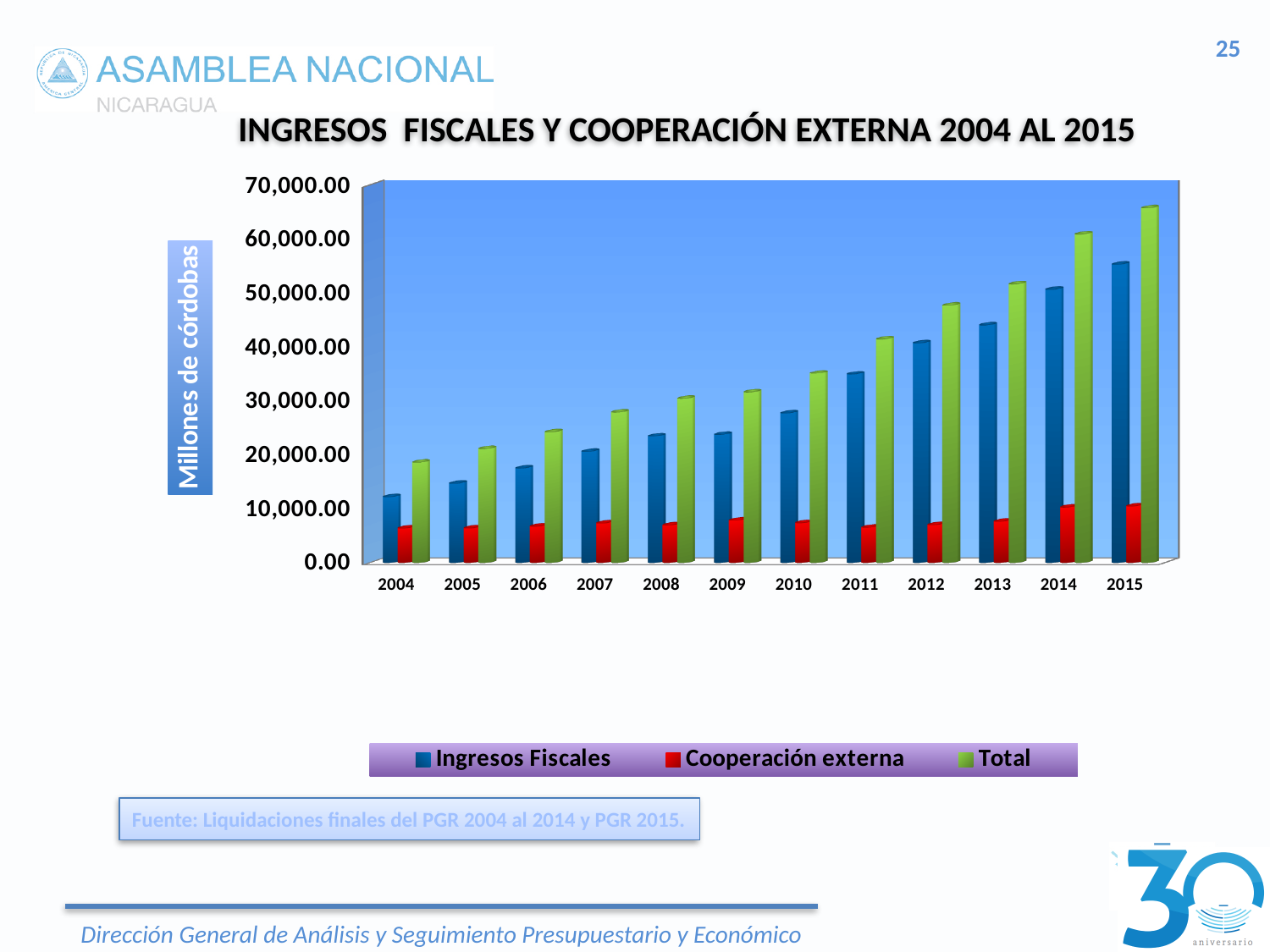
Which is larger in 2015, Ingresos Fiscales or Cooperación externa? Ingresos Fiscales Is the Total value for 2004 greater or less than 20,000.00? less What kind of chart is shown on the slide? bar chart In which year is the Total bar highest? 2015 What is the label on the vertical axis of the chart? Millones de córdobas Is the Cooperación externa value for 2004 greater or less than 10,000.00? less How many series does the legend list? 3 Do the Total values rise or fall from 2004 to 2015? rise How many years are shown on the x axis? 12 In which year is the Ingresos Fiscales bar lowest? 2004 Is the Ingresos Fiscales value for 2006 greater or less than 20,000.00? less